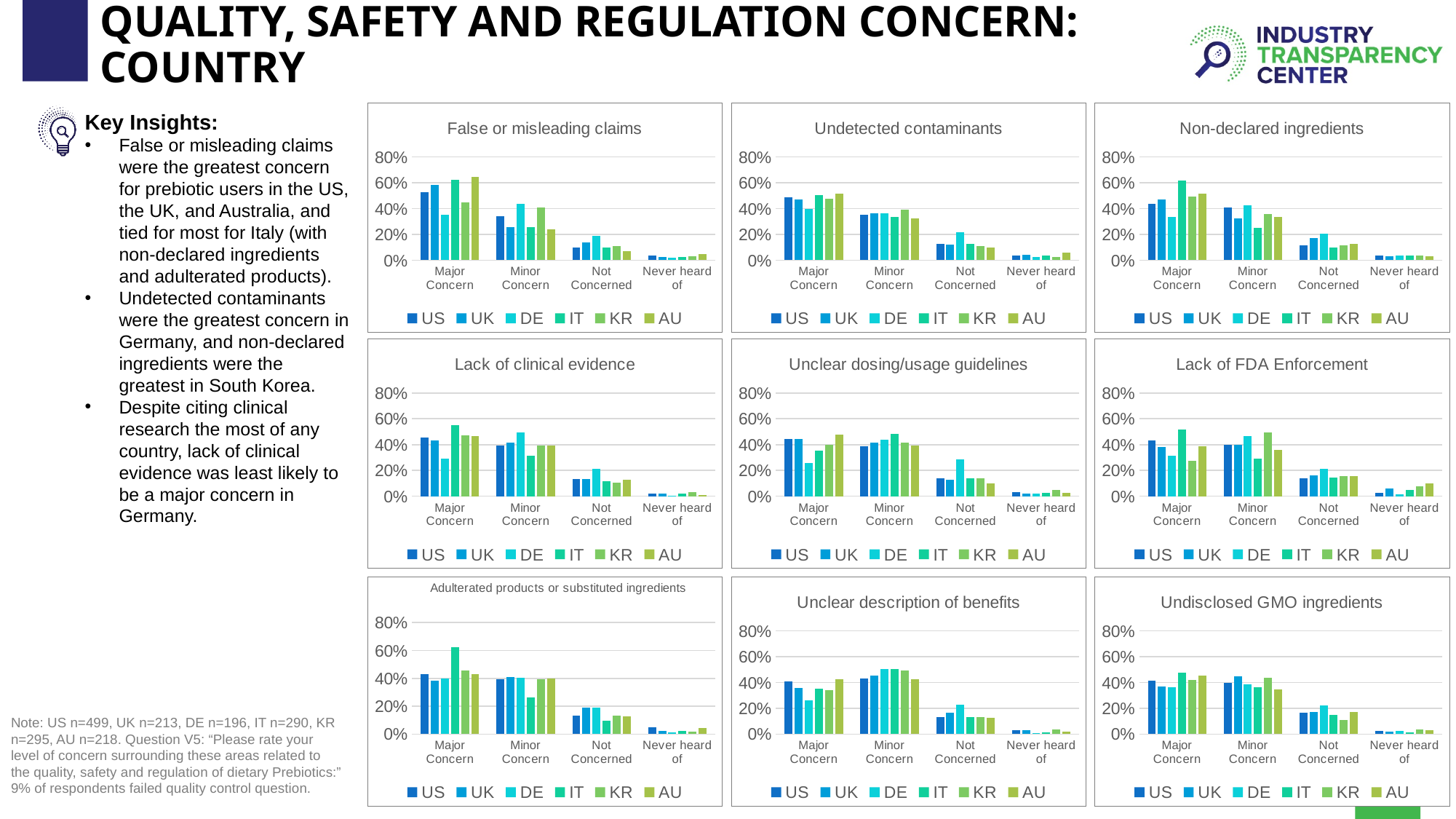
In the "Undetected contaminants" chart, is the value for US under Not Concerned greater or less than 20%? less How many charts are shown on the slide? 9 In the "Lack of clinical evidence" chart, which country has the highest Major Concern bar? IT How many series does the legend of the "Undetected contaminants" chart list? 6 In the "Lack of clinical evidence" chart, which country has the lowest Major Concern bar? DE In the "Undisclosed GMO ingredients" chart, is the value for IT under Major Concern greater or less than 40%? greater In the "False or misleading claims" chart, is the value for AU under Major Concern greater or less than 60%? greater In the "Unclear dosing/usage guidelines" chart, which country has the highest Not Concerned bar? DE In the "Adulterated products or substituted ingredients" chart, which country has the highest Major Concern bar? IT How many categories are shown on the x axis of the "Non-declared ingredients" chart? 4 In the "Non-declared ingredients" chart, which is larger under Major Concern, DE or US? US What kind of chart is the "False or misleading claims" chart? Bar chart